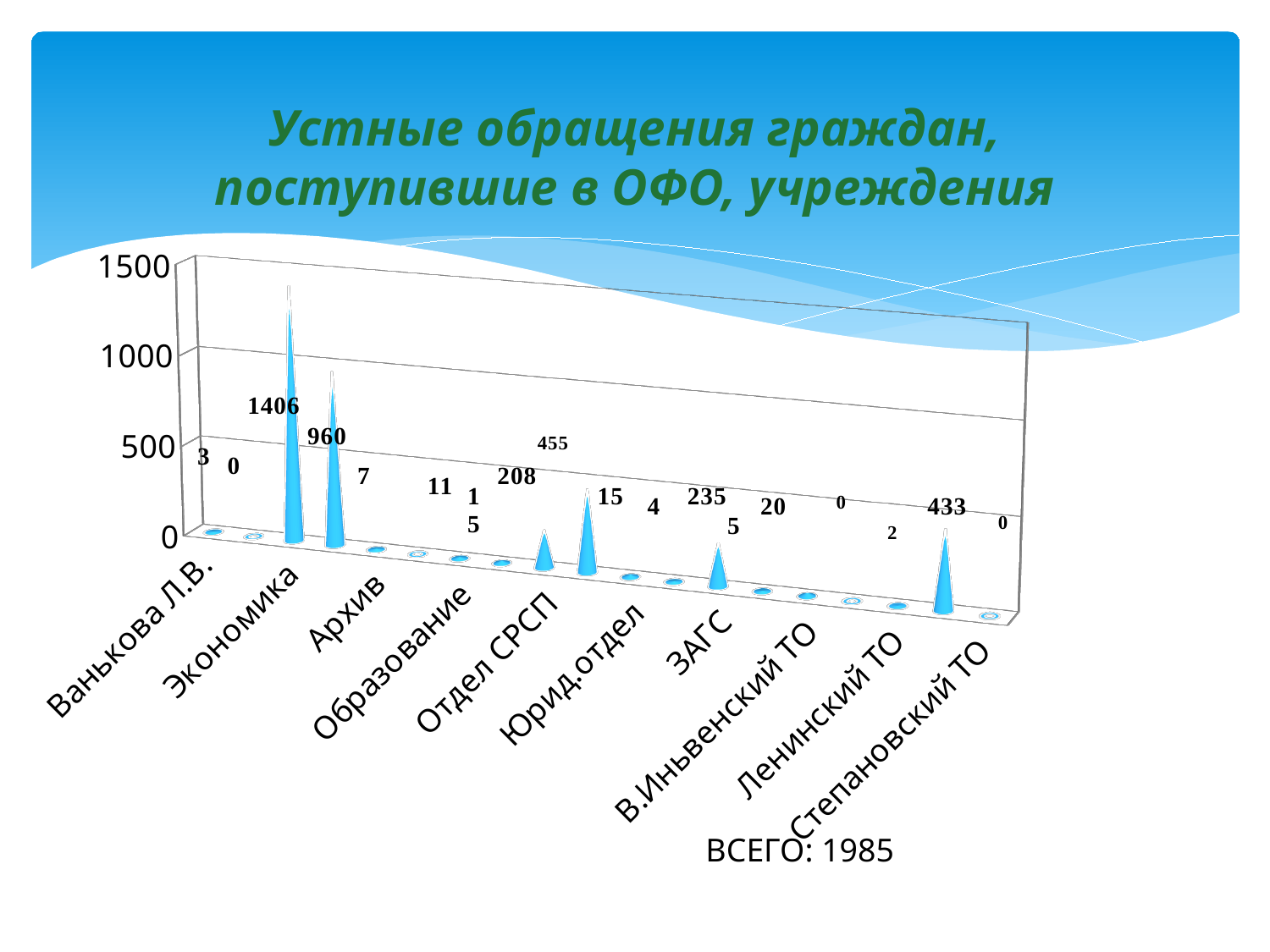
Which category has the highest value? Экономика What is the value for Степановский ТО? 0 What is the value for Экономика? 1406 What total (ВСЕГО) is printed below the chart? 1985 What is the value for ЗАГС? 235 Is the value for Экономика greater or less than 1000? greater What is the highest value shown on the chart? 1406 What type of chart is shown on the slide? bar chart What is the value for Отдел СРСП? 208 What is the title of the chart? Устные обращения граждан, поступившие в ОФО, учреждения What is the difference between the value for Экономика and the value for ЗАГС? 1171 Which is larger, the value for ЗАГС or the value for Отдел СРСП? ЗАГС